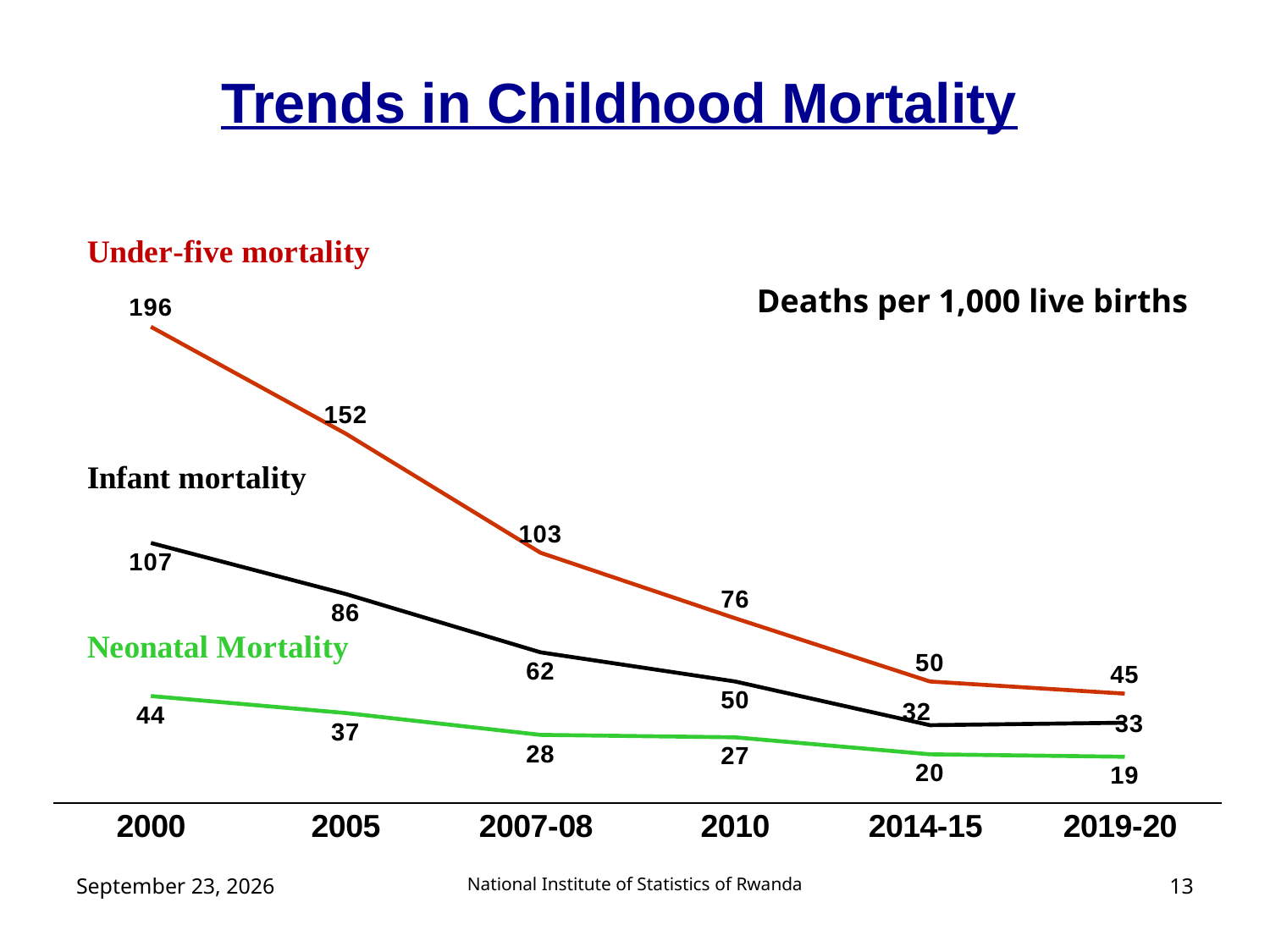
How many time periods are shown on the x axis? 6 What unit are the values on the chart expressed in? Deaths per 1,000 live births Which was higher in 2014-15: under-five mortality or infant mortality? Under-five mortality What was the neonatal mortality rate in 2019-20? 19 How many mortality series are plotted on the chart? 3 In which period was neonatal mortality lowest? 2019-20 What was the infant mortality rate in 2010? 50 By how much did under-five mortality fall between 2000 and 2019-20? 151 What was the under-five mortality rate in 2000? 196 What kind of chart is shown on the slide? Line chart In which year was under-five mortality highest? 2000 What is the difference between infant mortality and neonatal mortality in 2005? 49